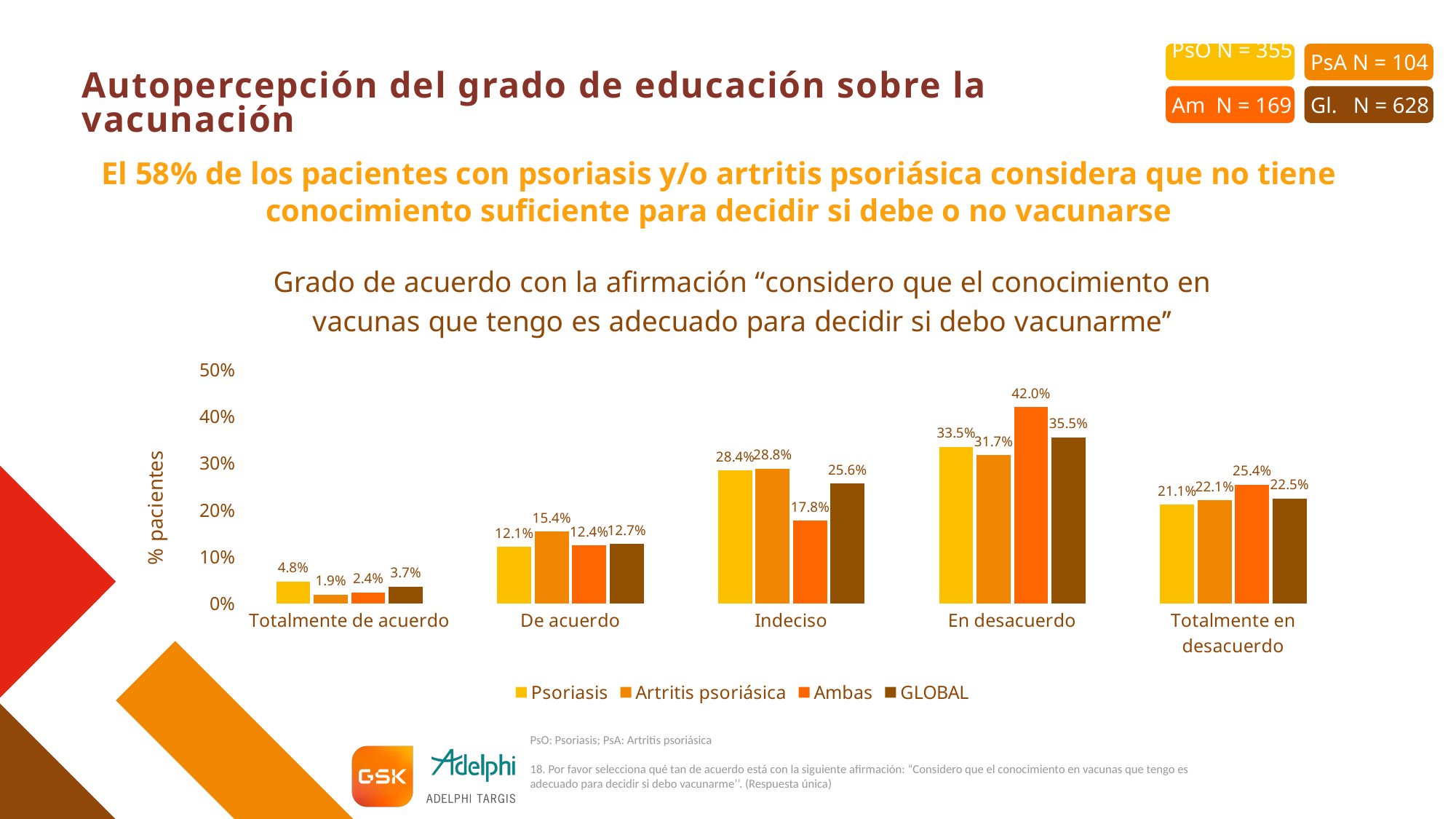
Which category has the highest GLOBAL value? En desacuerdo What is the difference between the Ambas and Psoriasis values in the En desacuerdo category? 8.5% In the Indeciso category, which is larger: the Psoriasis value or the Ambas value? Psoriasis What is the GLOBAL value for Indeciso? 25.6% How many response categories are shown on the x axis? 5 Which category has the lowest Psoriasis value? Totalmente de acuerdo What kind of chart is shown on the slide? Bar chart Is the Ambas value for En desacuerdo greater or less than 40%? greater How many series does the legend list? 4 What is the value for Artritis psoriásica in the Totalmente de acuerdo category? 1.9% What is the label of the y axis? % pacientes What is the value for Ambas in the En desacuerdo category? 42.0%